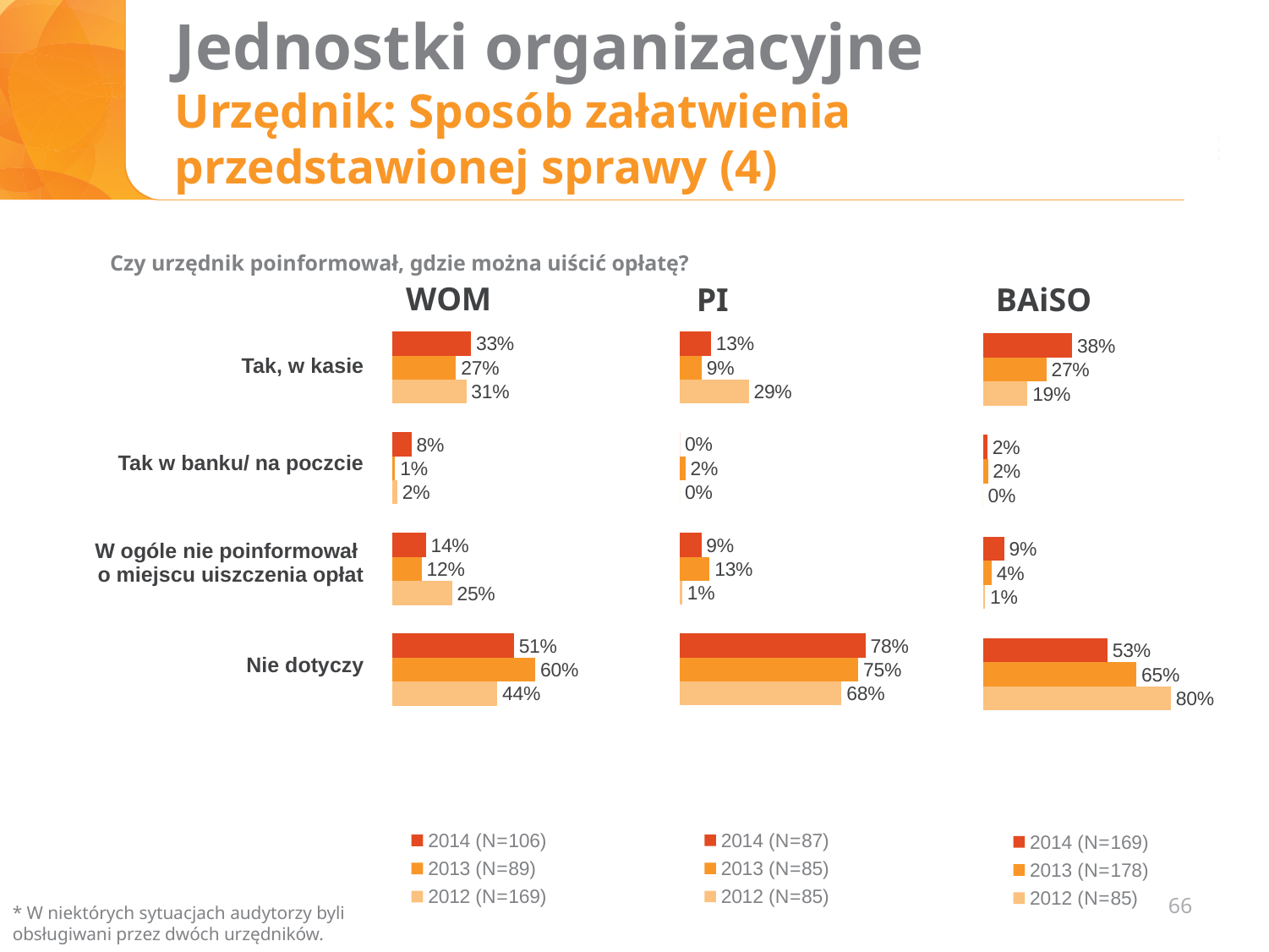
In the WOM chart, what is the difference between the 2013 (N=89) and 2014 (N=106) values for 'Nie dotyczy'? 9% In the WOM chart, what is the value for 'Tak, w kasie' in 2014 (N=106)? 33% In the PI chart, what is the value for 'Nie dotyczy' in 2012 (N=85)? 68% In the BAiSO chart, what is the value for 'W ogóle nie poinformował o miejscu uiszczenia opłat' in 2013 (N=178)? 4% How many categories are shown in the WOM chart? 4 In the PI chart, which category has the lowest value for 2014 (N=87)? Tak w banku/ na poczcie What is the sample size (N) for the 2013 series in the BAiSO chart legend? N=178 In the PI chart, which is larger for 'Tak, w kasie': the 2012 (N=85) value or the 2014 (N=87) value? 2012 (N=85) In the BAiSO chart, what is the difference between the 2014 (N=169) and 2012 (N=85) values for 'Tak, w kasie'? 19% What type of chart is the BAiSO chart? Bar chart In the BAiSO chart, which category has the highest value for 2012 (N=85)? Nie dotyczy How many series does the legend of the PI chart list? 3